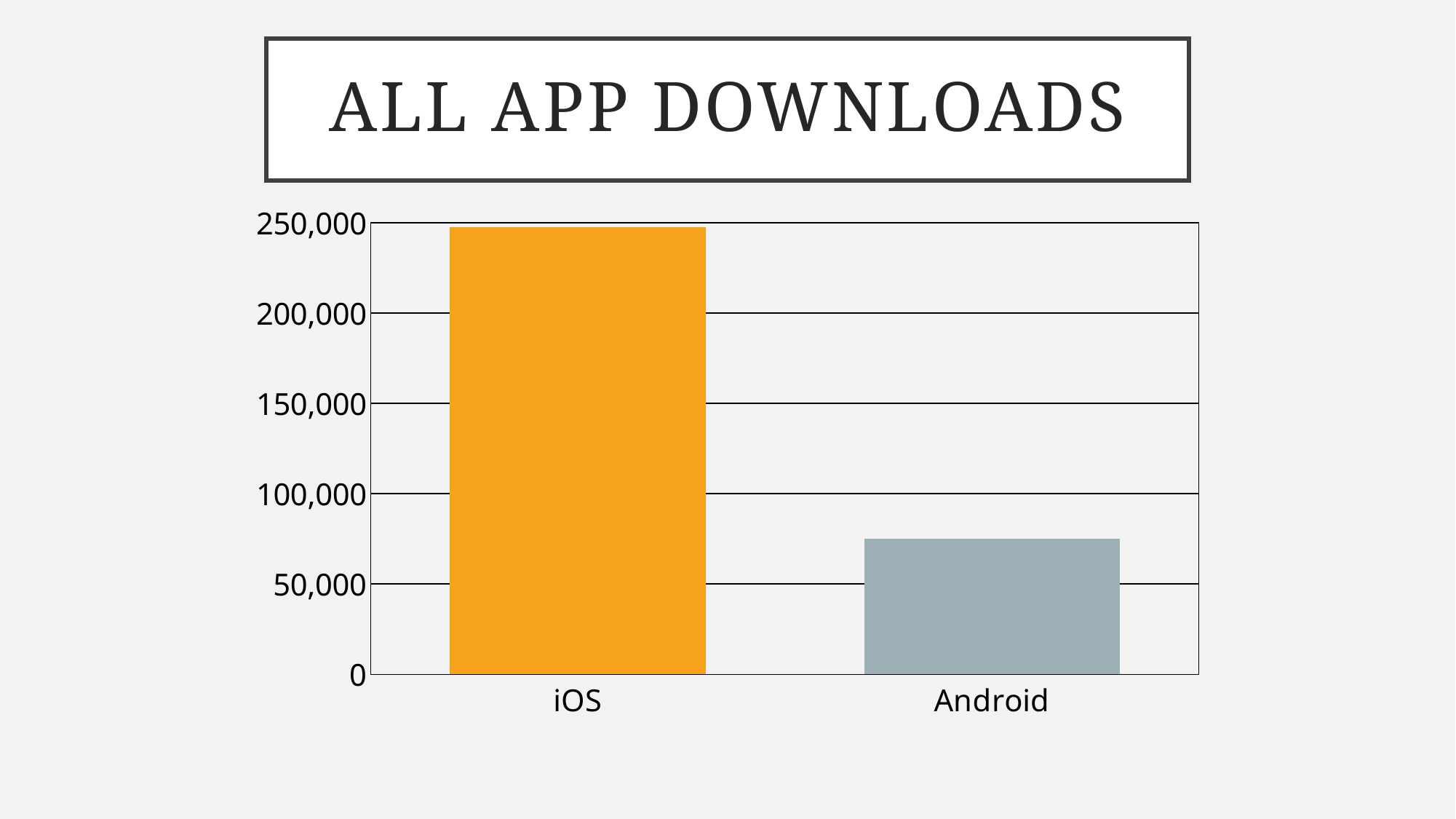
Is the value for Android greater or less than 50,000? greater What is the title of the slide above the chart? ALL APP DOWNLOADS Which category has the lowest value in the chart? Android How many categories are shown on the x axis of the chart? 2 Which has more downloads, iOS or Android? iOS What colour is the bar for iOS? orange What is the highest value labelled on the y axis? 250,000 Is the value for iOS greater or less than 150,000? greater Which category has the highest value in the chart? iOS Is the value for iOS greater or less than 200,000? greater What type of chart is shown on the slide? bar chart